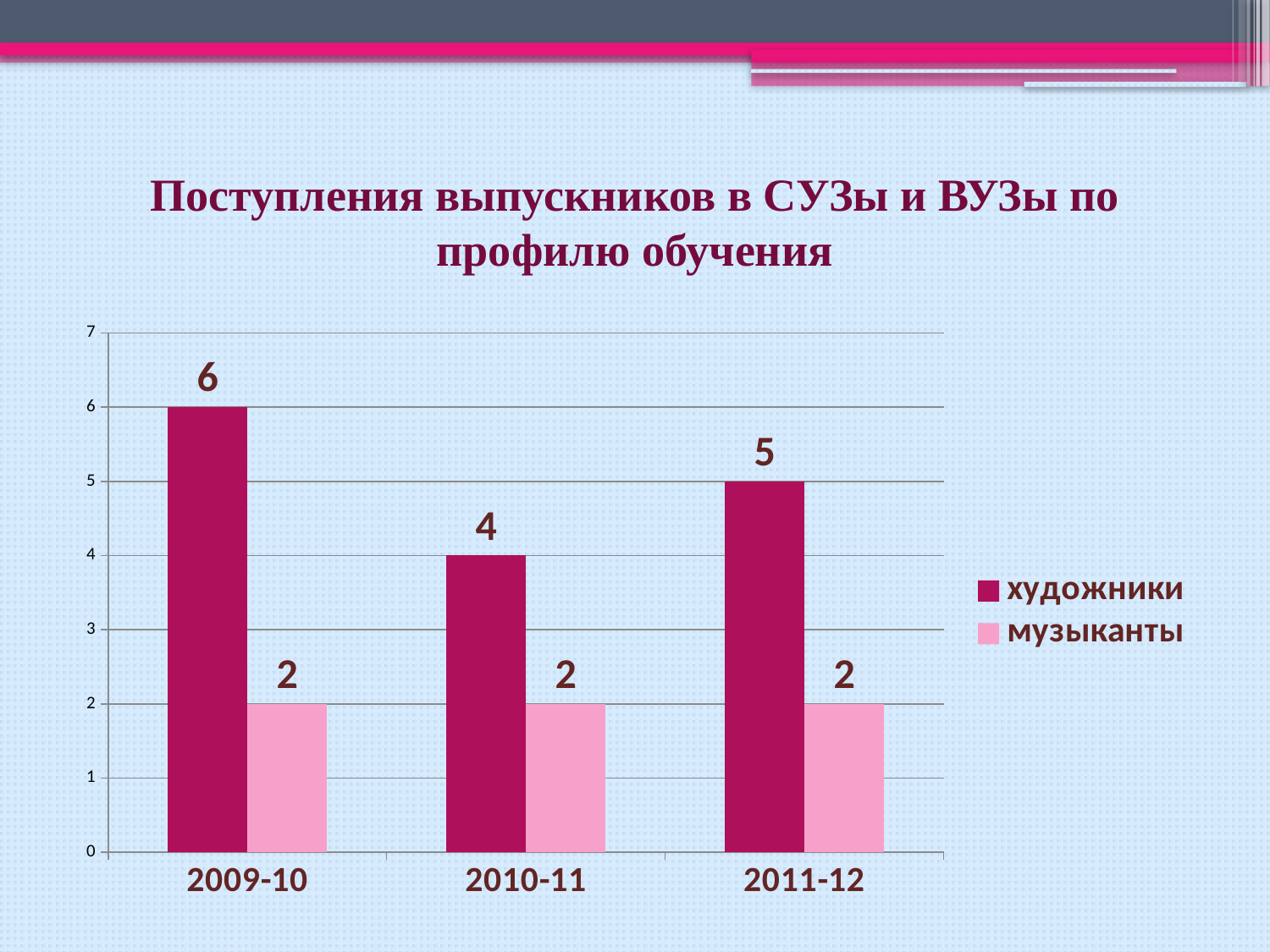
What is the value for художники in 2011-12? 5 In which year is the value for художники lowest? 2010-11 What kind of chart is shown on the slide? bar chart What is the difference between художники and музыканты in 2009-10? 4 In which year is the value for художники highest? 2009-10 How many year categories are shown on the x axis? 3 Does the value for музыканты rise, fall or stay the same across the years? stays the same What is the value for художники in 2009-10? 6 What is the value for музыканты in 2010-11? 2 What is the title of the chart? Поступления выпускников в СУЗы и ВУЗы по профилю обучения How many series does the legend list? 2 Which is larger in 2011-12, художники or музыканты? художники